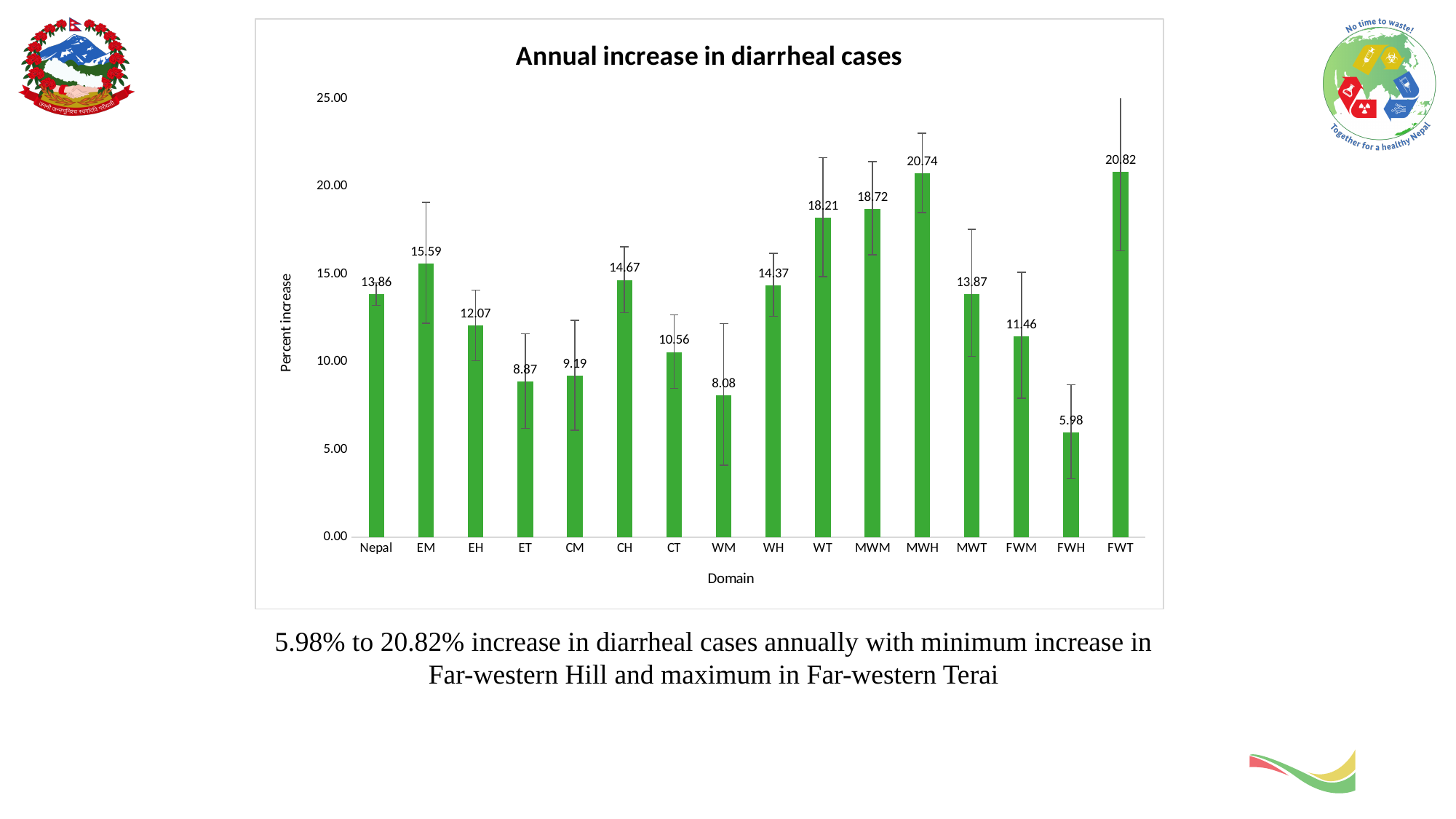
Which domain has the highest annual increase in diarrheal cases? FWT How many domains are plotted on the chart? 16 What is the title of the chart? Annual increase in diarrheal cases What is the annual percent increase in diarrheal cases for Nepal? 13.86 What is the difference between the values for MWM and WT? 0.51 What type of chart is shown on the slide? Bar chart Which has a larger value, EM or EH? EM What is the difference between the values for FWT and FWH? 14.84 Which domain has the lowest annual increase in diarrheal cases? FWH What is the value shown for the CT domain? 10.56 Which has a larger value, WM or CM? CM What is the value shown for the MWH domain? 20.74